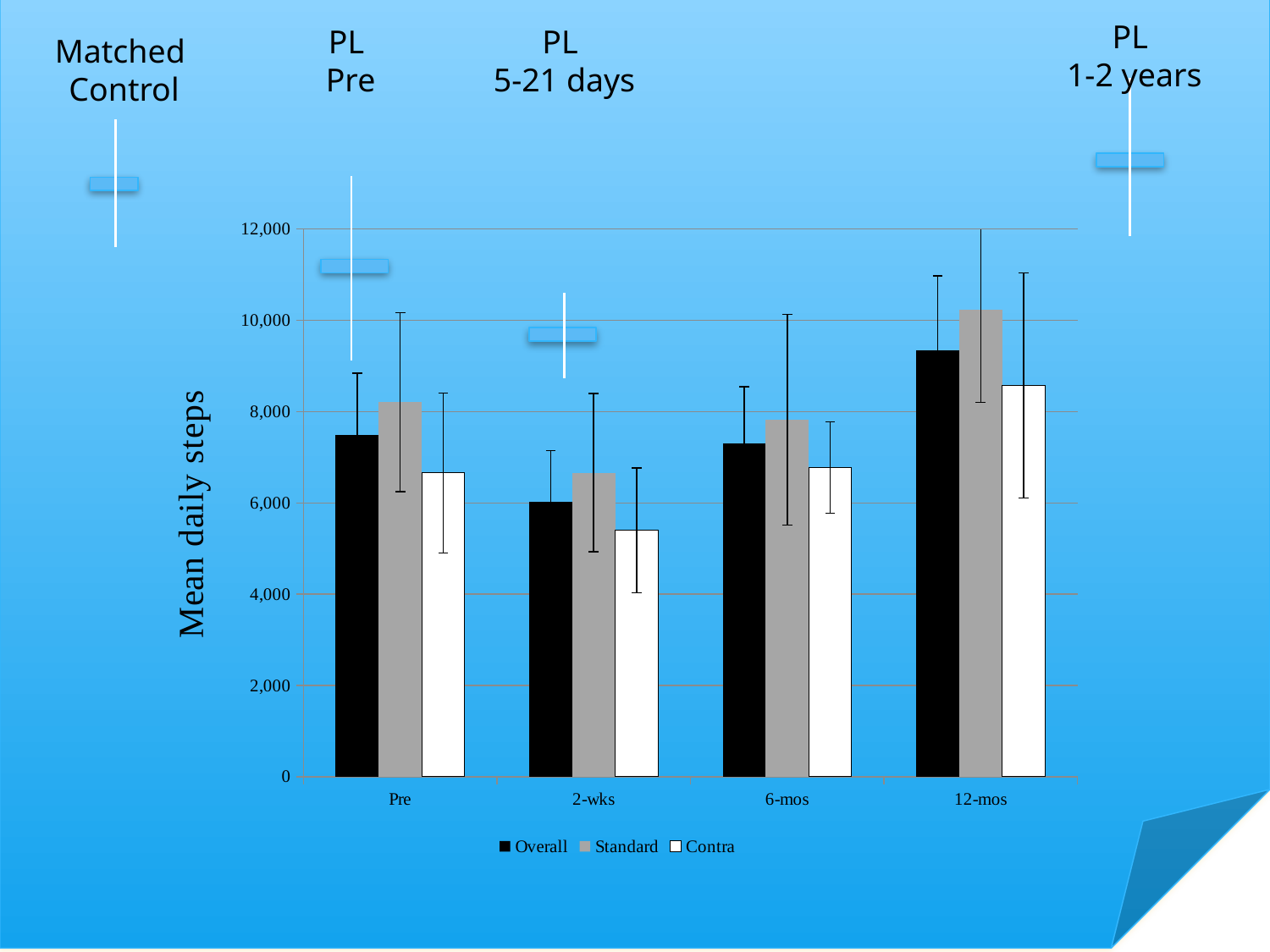
Is the Overall value at 12-mos greater or less than 8,000? greater Do the Overall bars rise or fall from 2-wks to 12-mos? rise Which series has the highest bar at 12-mos? Standard How many categories are shown along the x axis of the chart? 4 Is the Contra value at 2-wks greater or less than 6,000? less How many series does the chart legend list? 3 What is the title of the vertical axis of the chart? Mean daily steps Which series is shown with black bars in the chart? Overall Which series has the lowest bar at 2-wks? Contra At which category is the Overall bar lowest? 2-wks What kind of chart is shown on the slide? bar chart Which is larger: the Overall value at 12-mos or the Overall value at Pre? 12-mos